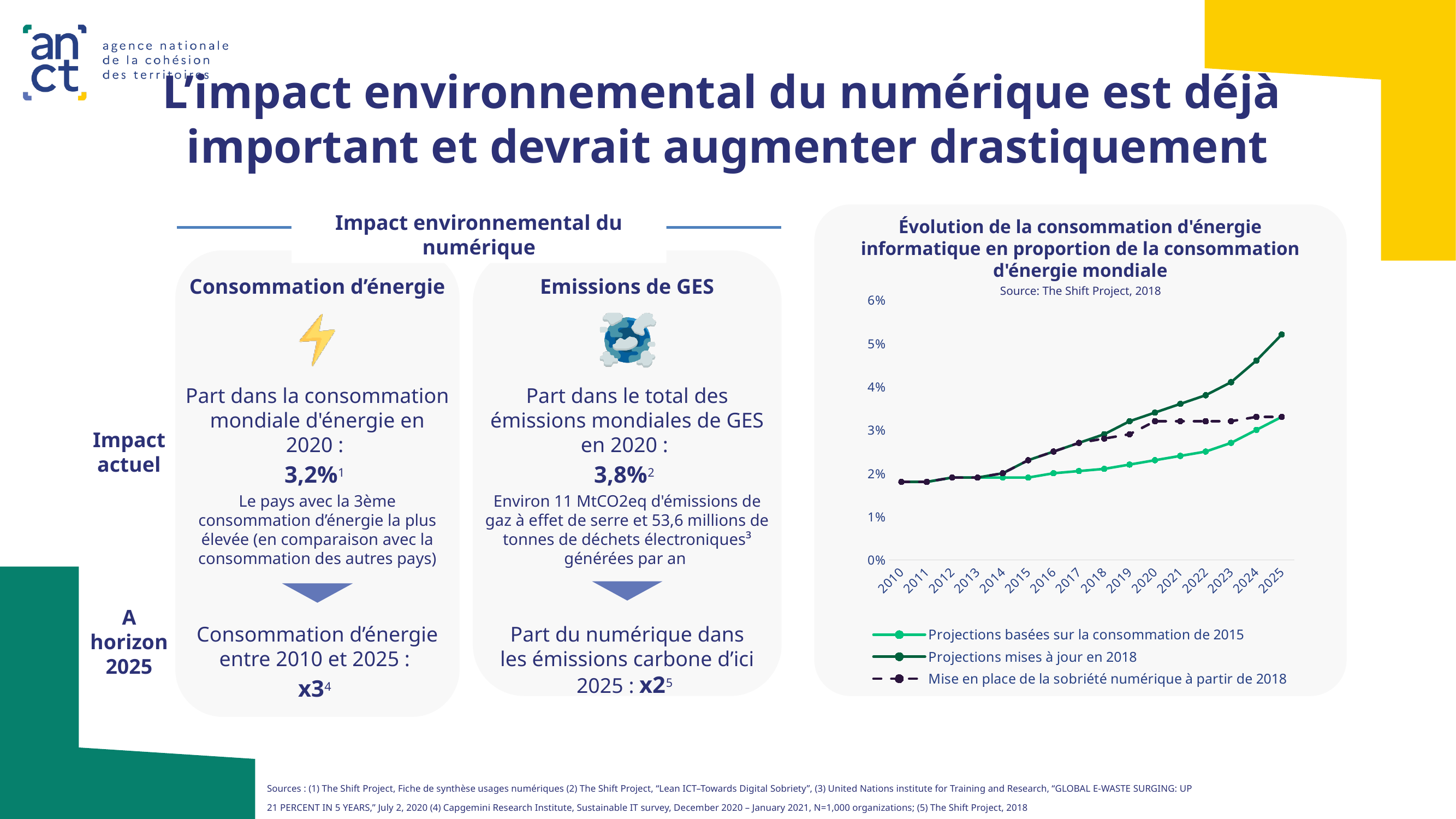
In 2020, which is larger: the value for 'Projections mises à jour en 2018' or the value for 'Projections basées sur la consommation de 2015'? Projections mises à jour en 2018 What is the first year shown on the x axis of the chart? 2010 Is the value for 'Projections mises à jour en 2018' in 2025 greater or less than 4%? greater What kind of chart is shown on the slide? line chart How many series does the chart legend list? 3 Is the value for 'Projections basées sur la consommation de 2015' in 2025 greater or less than 4%? less Is the value for 'Projections mises à jour en 2018' in 2010 greater or less than 2%? less What is the last year shown on the x axis of the chart? 2025 Which series reaches the highest value in 2025? Projections mises à jour en 2018 How many years are shown on the x axis of the chart? 16 Do the values of the 'Projections mises à jour en 2018' series rise or fall from 2010 to 2025? rise